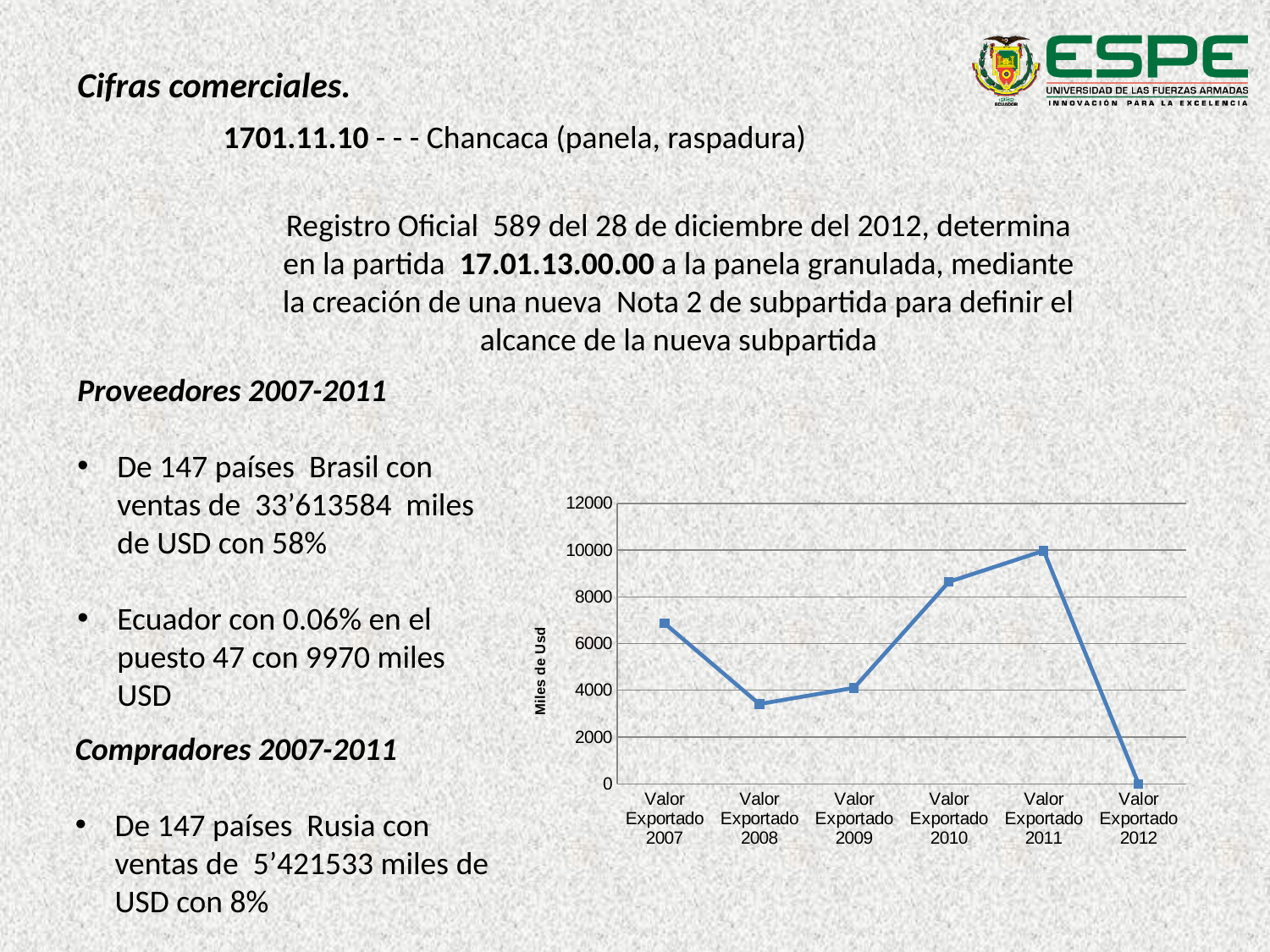
Which category has the lowest value on the line chart? Valor Exportado 2012 What is the value for Valor Exportado 2012? 0 Is the value for Valor Exportado 2008 greater or less than 4000? less Is the value for Valor Exportado 2007 greater or less than 6000? greater Which category has the highest value on the line chart? Valor Exportado 2011 Do the values rise or fall from Valor Exportado 2008 to Valor Exportado 2011? rise How many data points are plotted on the line chart? 6 Which is larger, the value for Valor Exportado 2010 or Valor Exportado 2007? Valor Exportado 2010 What is the title of the vertical axis on the line chart? Miles de Usd Is the value for Valor Exportado 2010 greater or less than 8000? greater Which is larger, the value for Valor Exportado 2009 or Valor Exportado 2008? Valor Exportado 2009 What kind of chart is shown on the slide? line chart